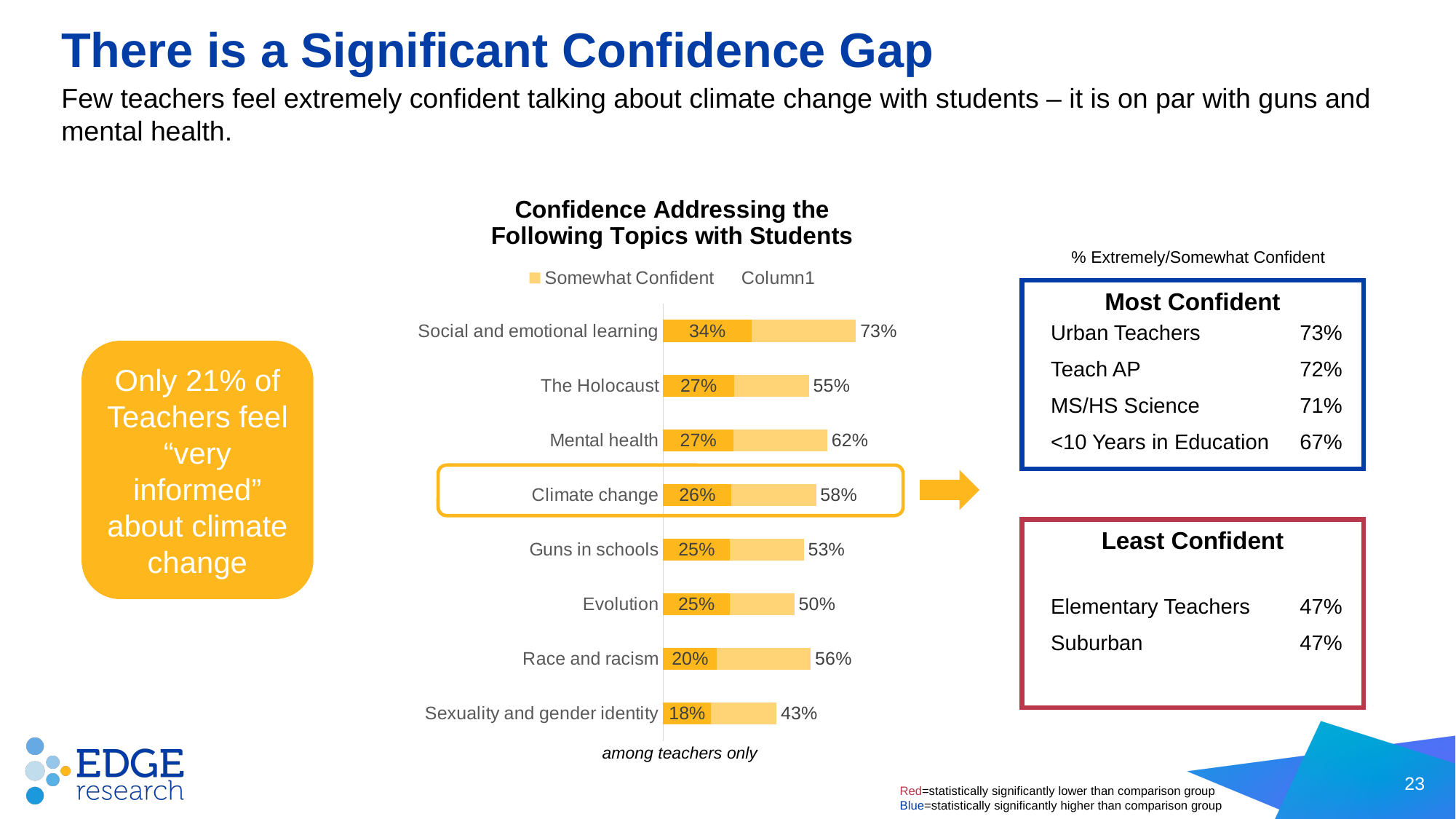
Which topic has the highest total value at the end of its bar? Social and emotional learning Which topic has the lowest value printed inside its dark orange segment? Sexuality and gender identity What is the total value printed at the end of the bar for Sexuality and gender identity? 43% What type of chart is shown under the title "Confidence Addressing the Following Topics with Students"? bar chart What is the value printed inside the dark orange segment for Climate change? 26% What is the total value printed at the end of the bar for Social and emotional learning? 73% Which topic on the chart is highlighted with an orange outline box? Climate change What is the difference between the total values for Mental health and Guns in schools? 9% How many topics are listed on the chart "Confidence Addressing the Following Topics with Students"? 8 How many entries does the legend of the chart list? 2 Which has a larger total value at the end of its bar: The Holocaust or Race and racism? Race and racism What is the difference between the dark orange segment values for Social and emotional learning and Climate change? 8%